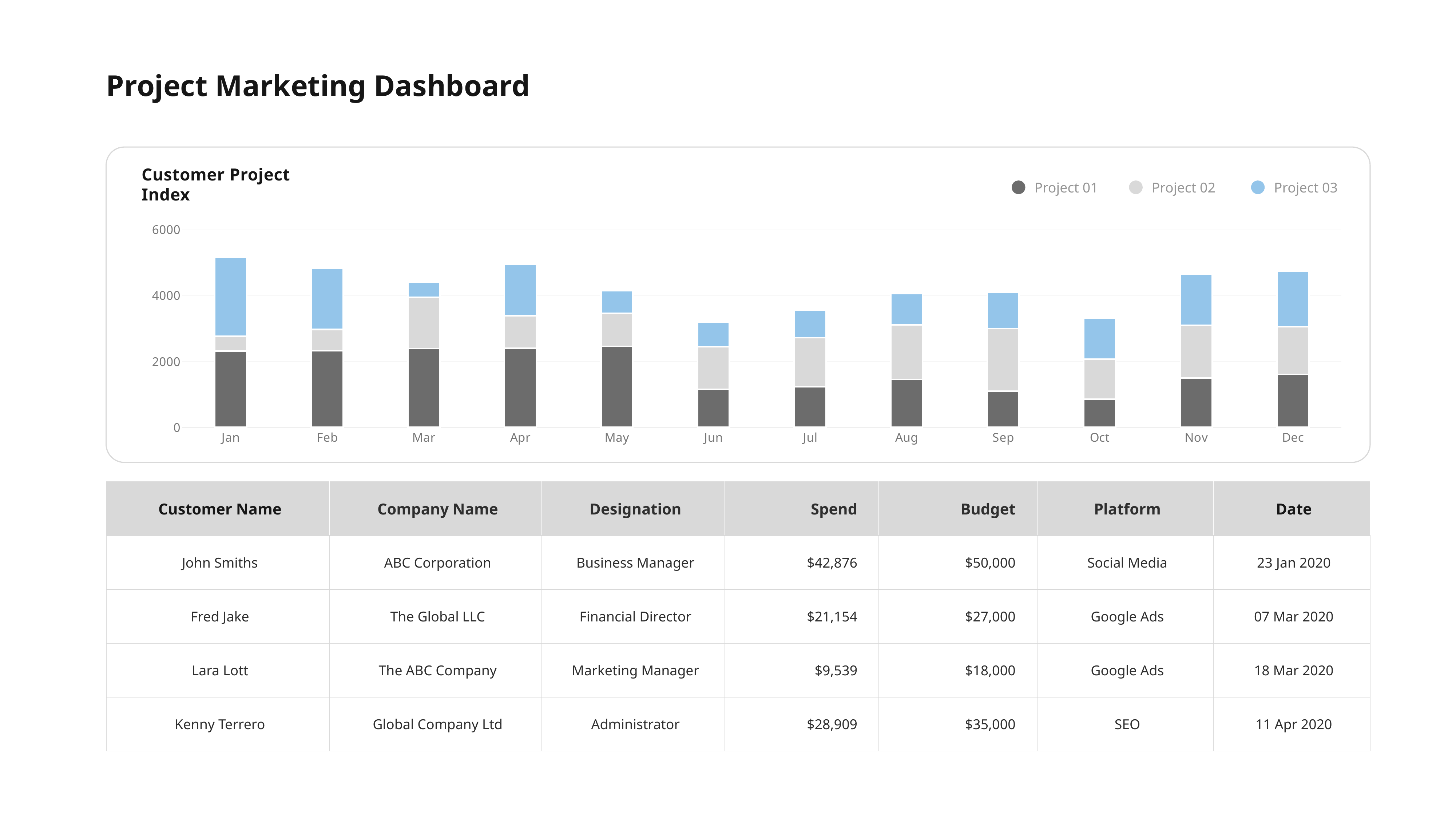
Is the total stacked value for Jan greater or less than 4000? greater Which colour represents Project 03 in the chart legend? Blue How many months are shown along the x axis of the chart? 12 Which has the larger total stacked value, Jan or Jun? Jan Is the Project 01 value for Oct greater or less than 2000? less How many series does the chart legend list? 3 What is the title of the chart? Customer Project Index Is the Project 01 value for Jan greater or less than 2000? greater Do the total stacked values rise or fall from Jan to Jun? Fall Which month has the lowest Project 01 value? Oct What kind of chart is shown on the slide? Stacked bar chart